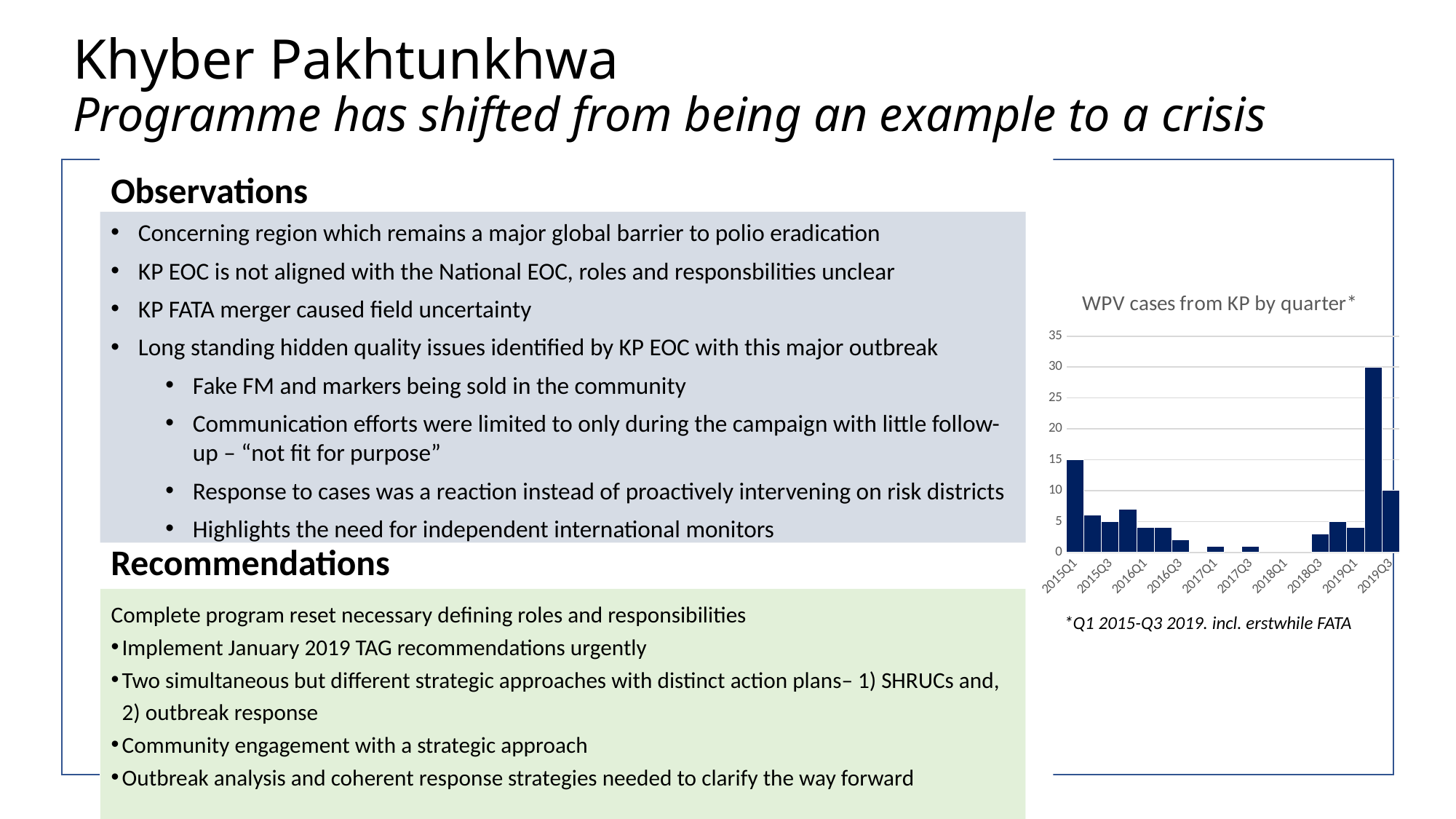
What is the value for 2015Q1 in the WPV cases chart? 15 Is the value for 2015Q1 greater or less than 10? greater What is the value for 2019Q3 in the WPV cases chart? 10 What is the title of the chart on the slide? WPV cases from KP by quarter* Which is larger, the value for 2015Q1 or the value for 2019Q3? 2015Q1 What is the difference between the values for 2015Q1 and 2019Q3? 5 What is the highest value shown on the y axis of the chart? 35 Is the value for 2019Q1 greater or less than 5? less What kind of chart is shown on the slide? bar chart Is the value for 2017Q1 greater or less than 5? less